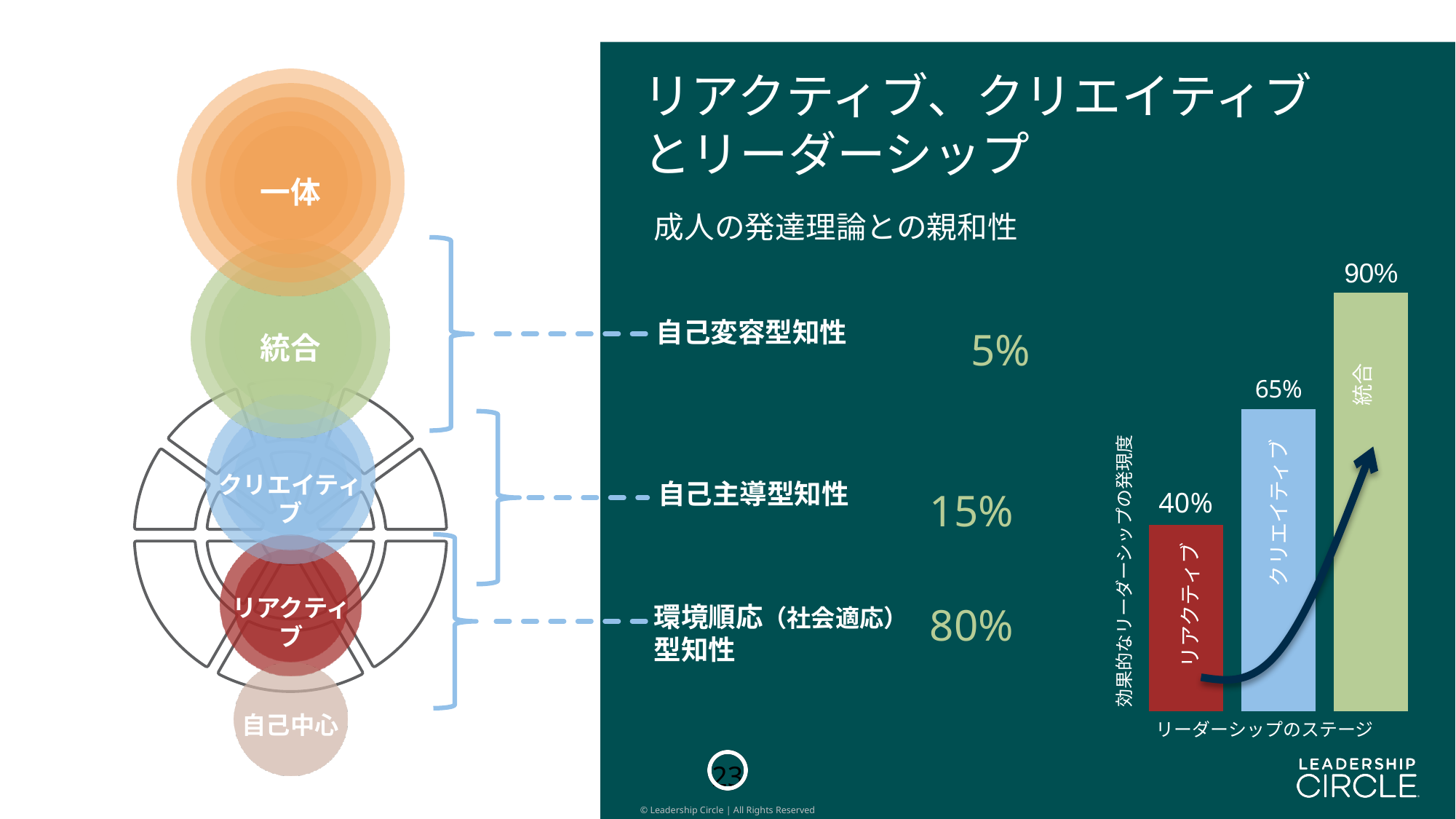
What is the difference between the values for 統合 and リアクティブ in the bar chart? 50% How many bars are shown in the bar chart? 3 Do the values in the bar chart rise or fall from left to right along the x axis? Rise Which category has the lowest value in the bar chart? リアクティブ What is the value for 統合 in the bar chart? 90% What is the value for クリエイティブ in the bar chart? 65% Which category has the highest value in the bar chart? 統合 Which is larger in the bar chart, the value for クリエイティブ or the value for 統合? 統合 What is the difference between the values for クリエイティブ and リアクティブ in the bar chart? 25% What is the x-axis label of the bar chart? リーダーシップのステージ What is the value for リアクティブ in the bar chart? 40% What kind of chart is shown on the right side of the slide? Bar chart